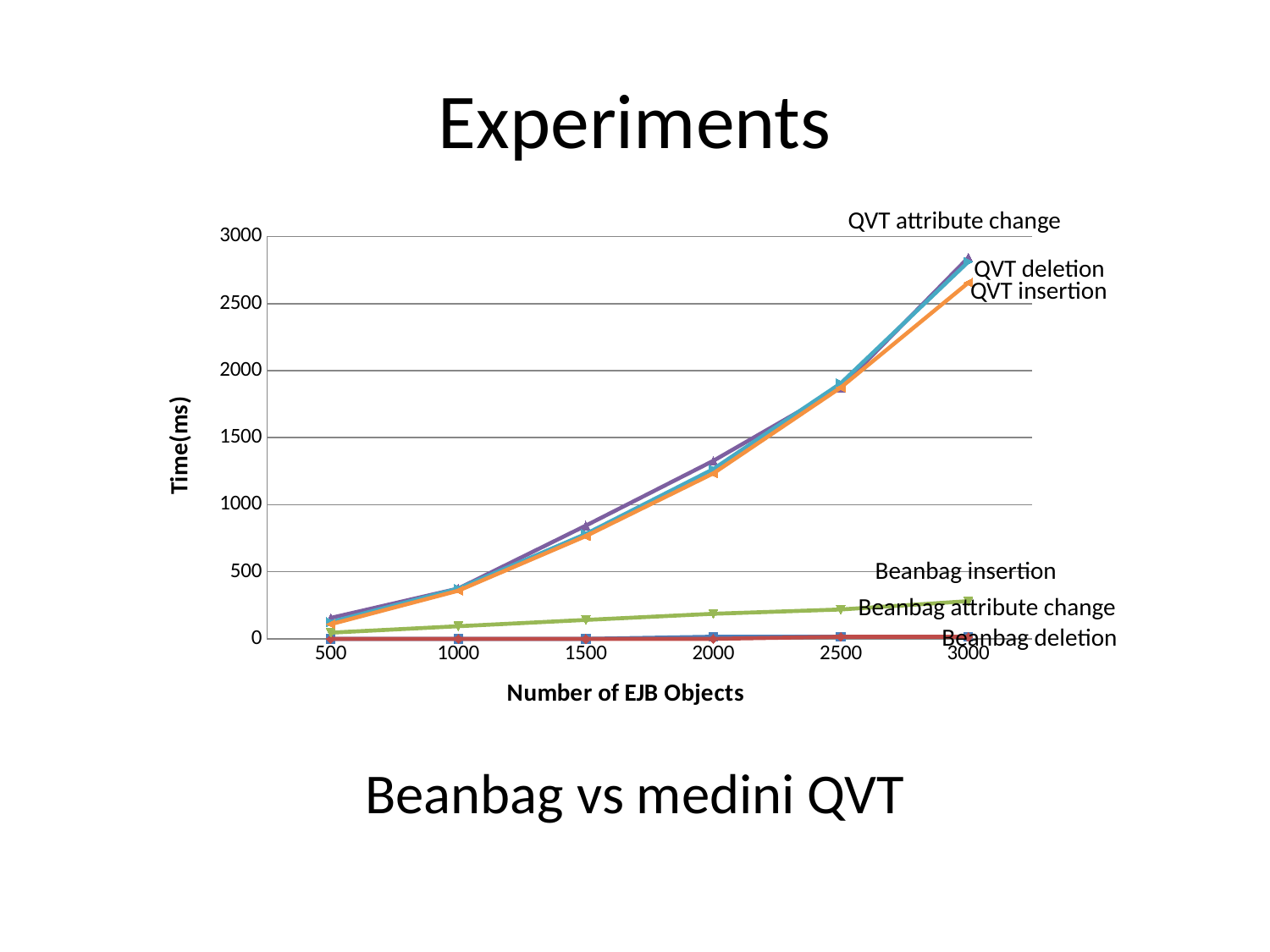
Is the value for QVT insertion at 3000 EJB objects greater or less than 2500? greater Does the QVT insertion line rise or fall as the number of EJB objects increases? rises How many values of Number of EJB Objects are plotted along the x axis? 6 What is the title of the y axis? Time(ms) Is the value for QVT deletion at 2500 EJB objects greater or less than 2000? less Is the value for QVT attribute change at 1500 EJB objects greater or less than 1000? less What kind of chart is shown on the slide? line chart At 3000 EJB objects, which is larger: QVT insertion or Beanbag insertion? QVT insertion How many data series are labelled on the chart? 6